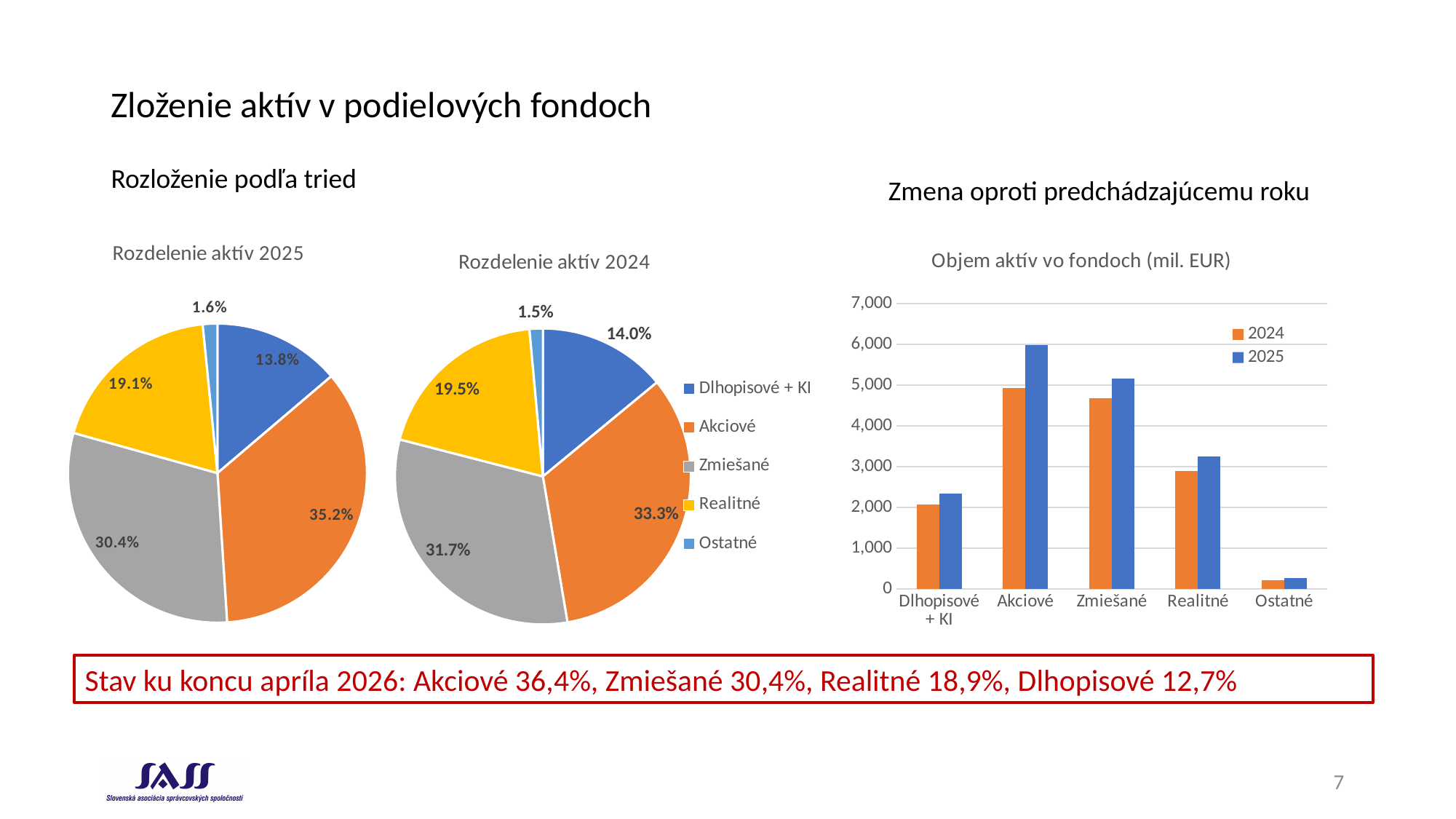
In the 'Rozdelenie aktív 2024' pie chart, which category has the smallest share? Ostatné How many series does the legend of the 'Objem aktív vo fondoch (mil. EUR)' chart list? 2 In the 'Rozdelenie aktív 2025' pie chart, what share does Akciové have? 35.2% In the 'Rozdelenie aktív 2025' pie chart, what is the difference between the Akciové and Zmiešané shares? 4.8% How many slices does the 'Rozdelenie aktív 2025' pie chart have? 5 In the 'Objem aktív vo fondoch (mil. EUR)' chart, is the 2024 value for Zmiešané greater or less than 5,000? less In the 'Rozdelenie aktív 2024' pie chart, what share does Zmiešané have? 31.7% What type of chart is 'Objem aktív vo fondoch (mil. EUR)'? bar chart In the 'Objem aktív vo fondoch (mil. EUR)' chart, which category has the highest 2025 value? Akciové In the 'Objem aktív vo fondoch (mil. EUR)' chart, is the 2025 value for Akciové greater or less than 5,000? greater In the 'Rozdelenie aktív 2025' pie chart, which category has the largest share? Akciové Is the Realitné share larger in the 'Rozdelenie aktív 2025' pie chart or in the 'Rozdelenie aktív 2024' pie chart? Rozdelenie aktív 2024